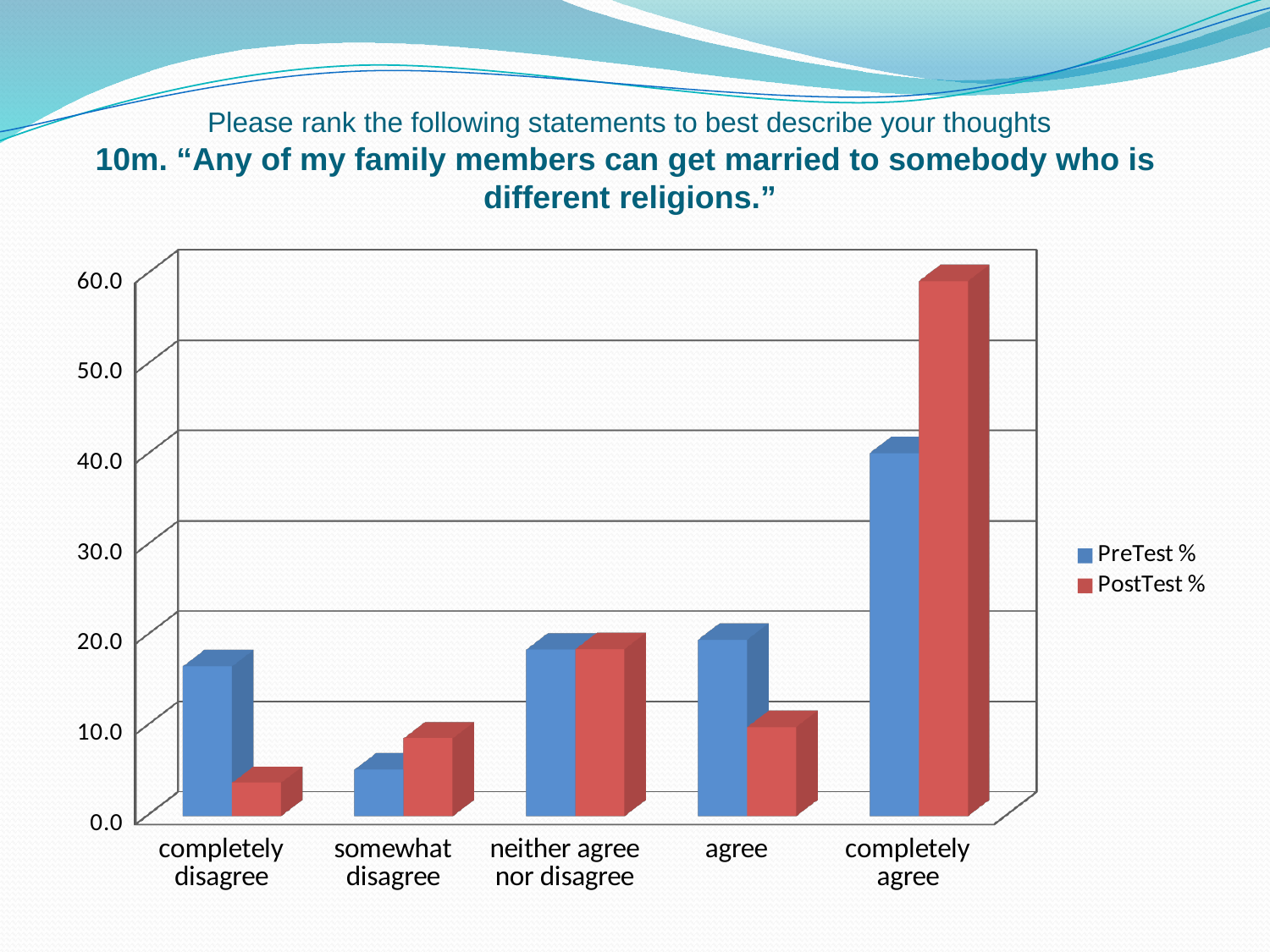
For 'completely disagree', which is larger: PreTest % or PostTest %? PreTest % What kind of chart is shown on the slide? bar chart Is the PostTest % value for 'completely disagree' greater or less than 10.0? less Which category has the highest PostTest % value? completely agree What are the two legend entries of the chart? PreTest % and PostTest % How many response categories are shown on the x axis? 5 Which category has the highest PreTest % value? completely agree Which category has the lowest PreTest % value? somewhat disagree How many series does the legend list? 2 Which category has the lowest PostTest % value? completely disagree For 'completely agree', which is larger: PreTest % or PostTest %? PostTest % Is the PostTest % value for 'completely agree' greater or less than 50.0? greater